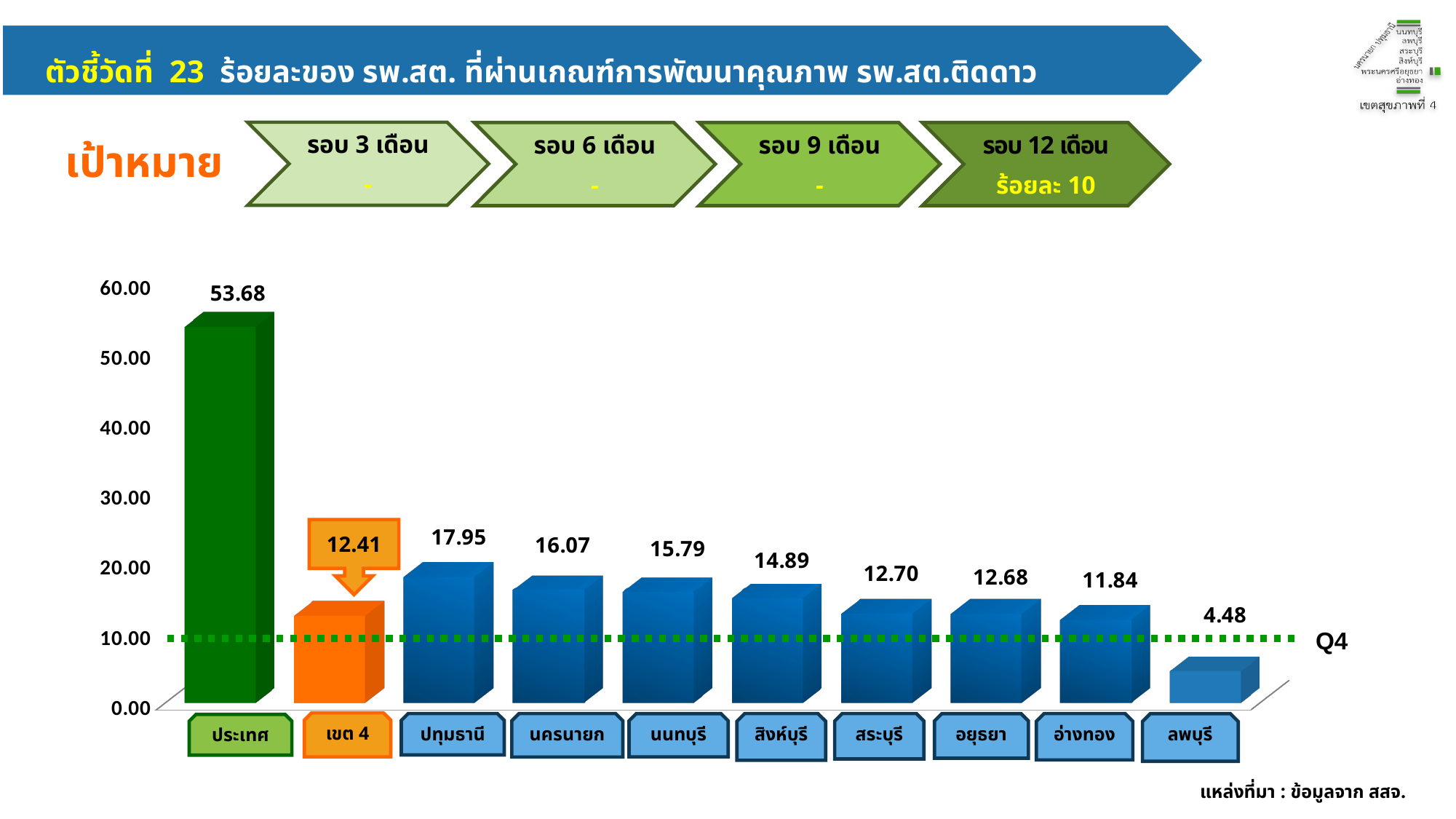
What is the value for เขต 4? 12.41 What label is shown next to the dotted horizontal line at 10.00? Q4 What is the value for ลพบุรี? 4.48 How many categories are shown on the x axis of the chart? 10 Which category has the highest value? ประเทศ What is the difference between the values for ปทุมธานี and นนทบุรี? 2.16 What is the value for ประเทศ? 53.68 What is the value for นครนายก? 16.07 What kind of chart is shown on the slide? bar chart Is the value for ลพบุรี greater or less than 10.00? less Which is larger, the value for สิงห์บุรี or the value for อ่างทอง? สิงห์บุรี Which category has the lowest value? ลพบุรี